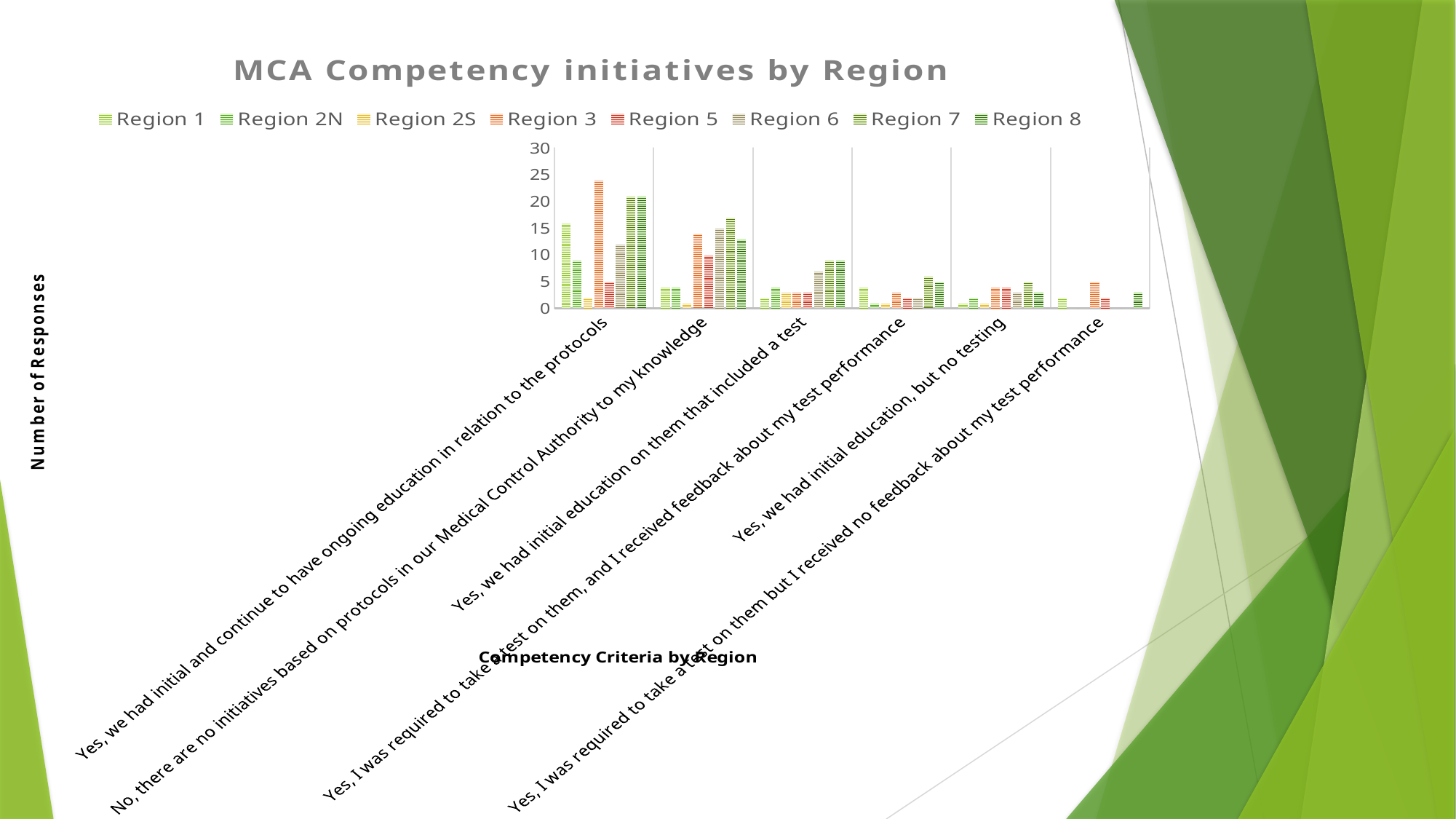
In 'No, there are no initiatives based on protocols in our Medical Control Authority to my knowledge', which is larger: Region 7 or Region 8? Region 7 In 'Yes, we had initial and continue to have ongoing education in relation to the protocols', which is larger: Region 3 or Region 1? Region 3 Is the value for Region 7 in 'No, there are no initiatives based on protocols in our Medical Control Authority to my knowledge' greater or less than 15? greater What kind of chart is shown on the slide? bar chart How many regions does the legend list? 8 Is the value for Region 3 in 'Yes, we had initial and continue to have ongoing education in relation to the protocols' greater or less than 20? greater Which region has the highest bar for 'Yes, we had initial and continue to have ongoing education in relation to the protocols'? Region 3 How many competency criteria categories are shown on the x axis? 6 What is the label on the vertical axis? Number of Responses Is the value for Region 8 in 'No, there are no initiatives based on protocols in our Medical Control Authority to my knowledge' greater or less than 10? greater What is the title of the chart? MCA Competency initiatives by Region